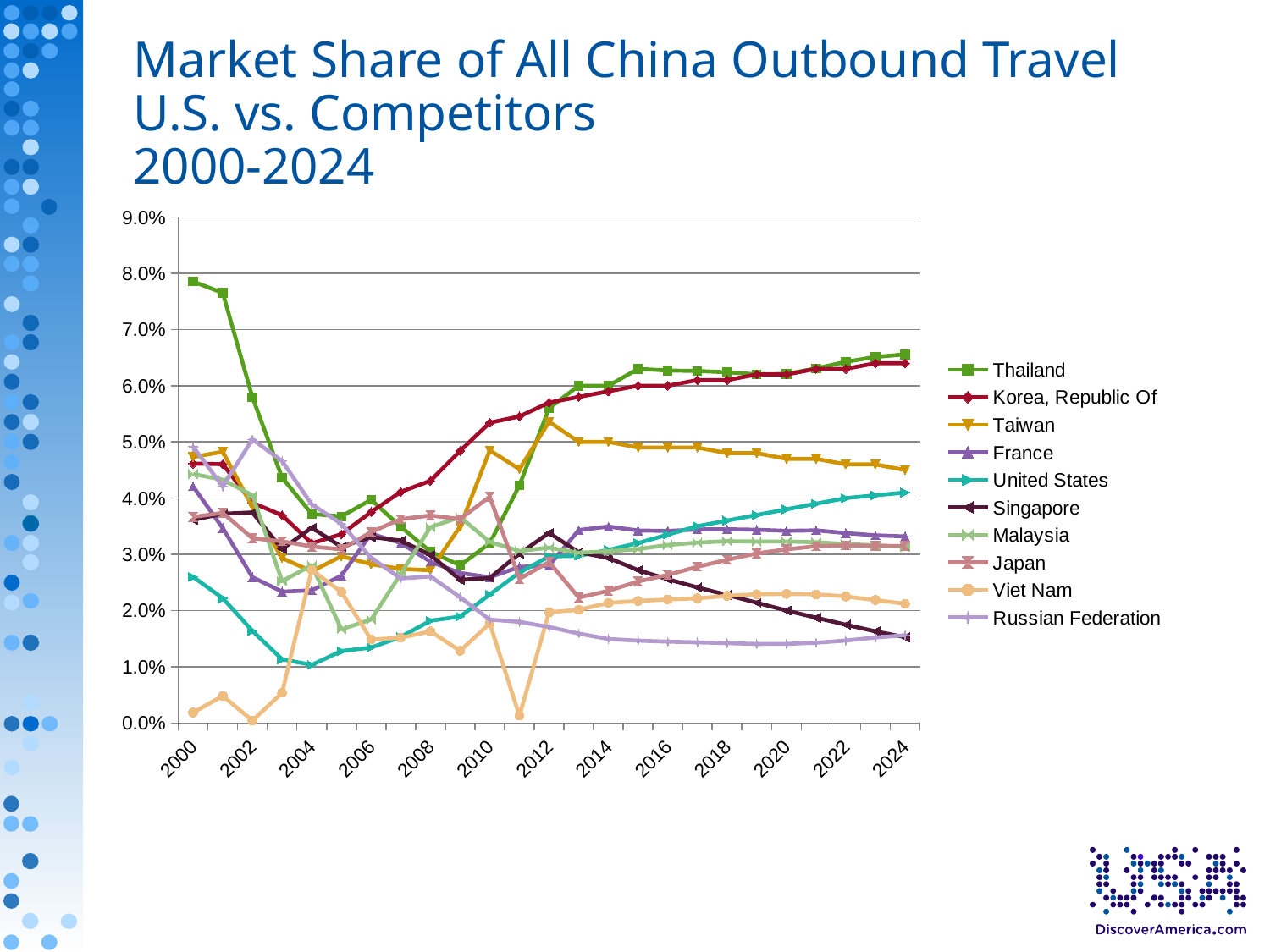
Is the value for Singapore in 2024 greater or less than 2.0%? less What is the title of the chart? Market Share of All China Outbound Travel U.S. vs. Competitors 2000-2024 Is the value for Viet Nam in 2011 greater or less than 1.0%? less Is the value for Thailand in 2000 greater or less than 7.0%? greater Which series has the highest market share in 2000? Thailand How many years (data points per series) are plotted along the x axis, from 2000 to 2024? 25 How many series does the legend list? 10 What kind of chart is shown on the slide? line chart Which series has the lowest market share in 2000? Viet Nam Does the United States line rise or fall from 2004 to 2024? rise In 2024, which is larger: the value for Korea, Republic Of or the value for Singapore? Korea, Republic Of